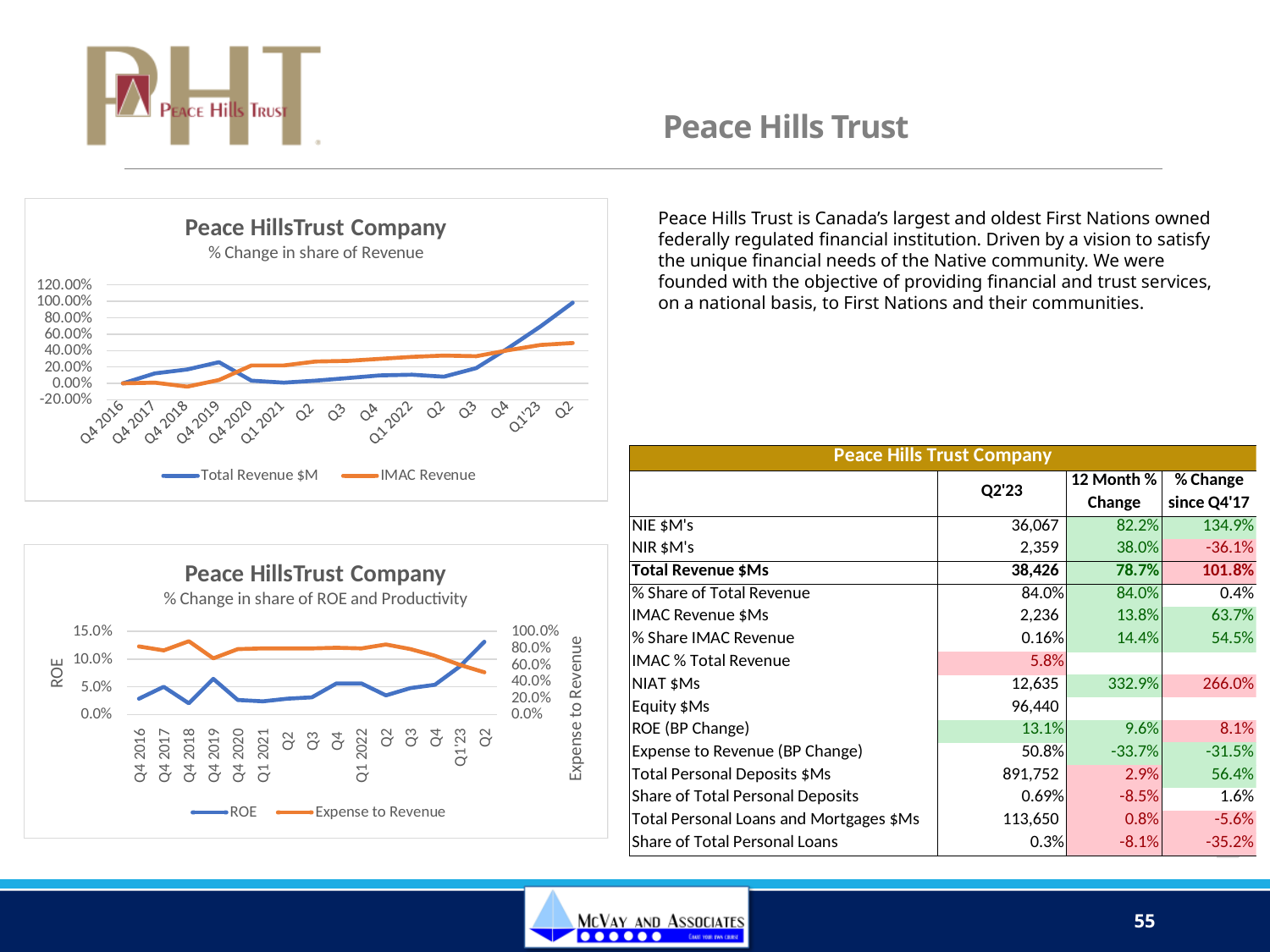
In the top chart (% Change in share of Revenue), which series is higher at the final Q2 point, Total Revenue $M or IMAC Revenue? Total Revenue $M How many series does the legend of the top chart (% Change in share of Revenue) list? 2 In the top chart (% Change in share of Revenue), does the Total Revenue $M line generally rise or fall from Q4 2016 to the final Q2? Rise In the top chart (% Change in share of Revenue), is the value for IMAC Revenue at the final Q2 point greater or less than 60.00%? less In the bottom chart (% Change in share of ROE and Productivity), is the value for ROE at the final Q2 point greater or less than 10.0%? greater In the top chart (% Change in share of Revenue), is the value for Total Revenue $M at the final Q2 point greater or less than 80.00%? greater In the top chart (% Change in share of Revenue), which series is shown in orange? IMAC Revenue What is the subtitle of the bottom chart titled 'Peace HillsTrust Company'? % Change in share of ROE and Productivity How many series does the legend of the bottom chart (% Change in share of ROE and Productivity) list? 2 How many points are plotted along the x axis of the top chart (% Change in share of Revenue)? 15 What type of chart is the top chart titled 'Peace HillsTrust Company' (% Change in share of Revenue)? Line chart